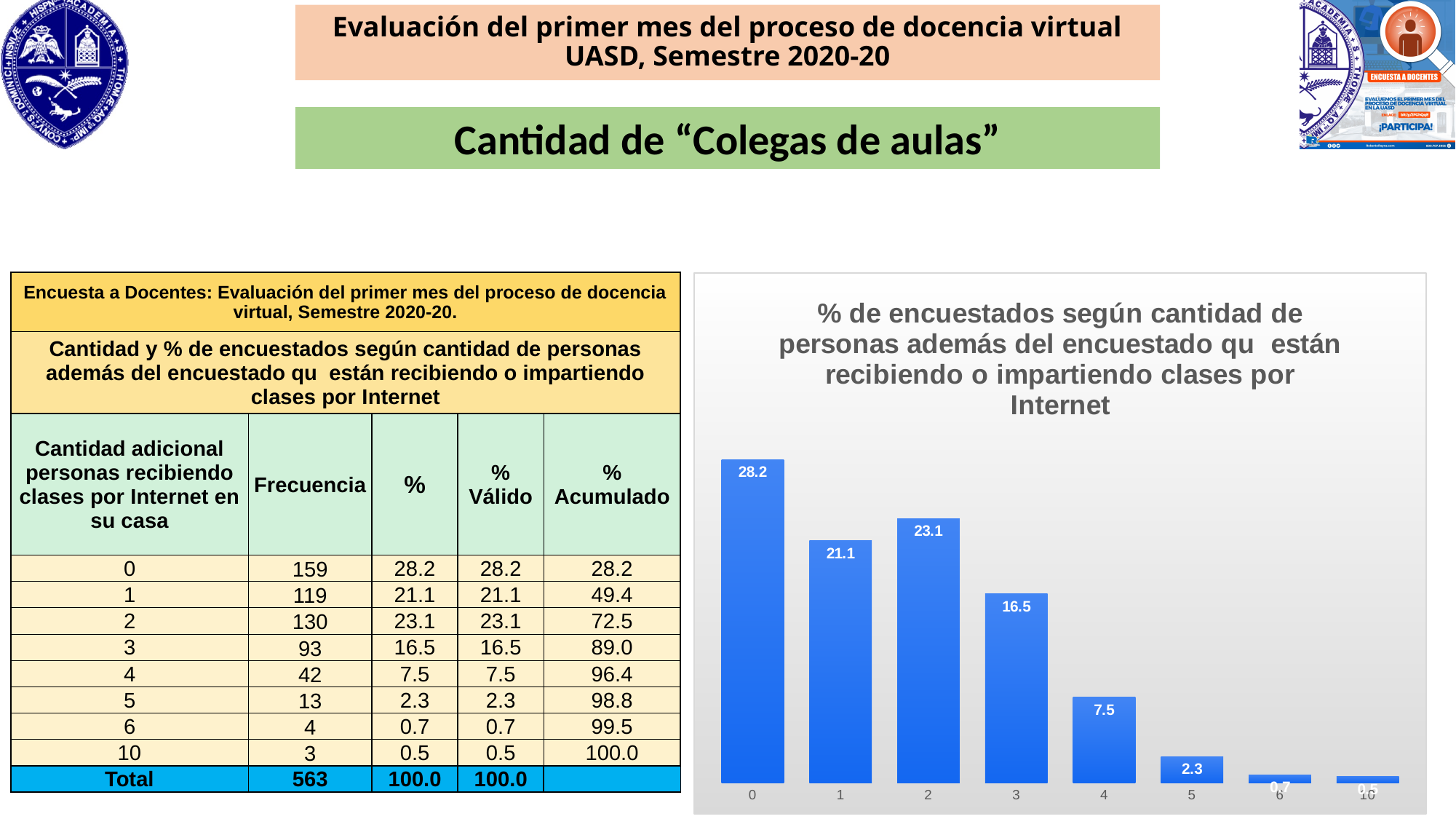
What is the difference between the values for categories 0 and 1 in the chart? 7.1 Do the values in the chart generally rise or fall from category 2 to category 10? fall What is the value for category 3 in the chart? 16.5 Which category has the highest value in the chart? 0 Which is larger in the chart, the value for category 1 or category 2? 2 What is the value for category 4 in the chart? 7.5 How many categories are shown on the x axis of the chart? 8 What kind of chart is shown on the slide? bar chart Which category has the lowest value in the chart? 10 What is the value for category 0 in the chart? 28.2 What is the difference between the values for categories 2 and 3 in the chart? 6.6 What is the value for category 5 in the chart? 2.3